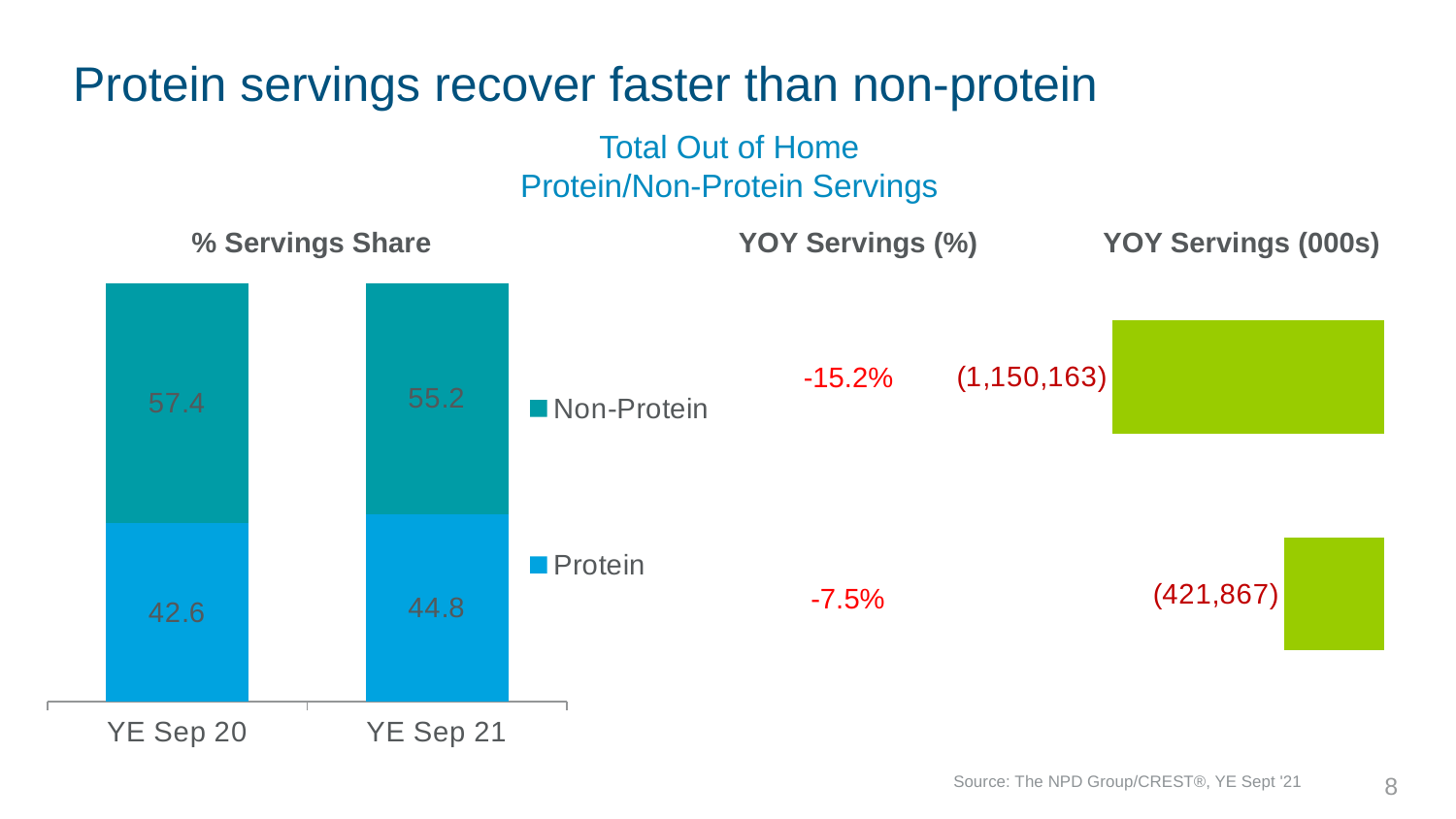
How many categories are shown on the x axis of the % Servings Share chart? 2 What kind of chart is the % Servings Share chart? Stacked bar chart In the % Servings Share chart, what is the total of the stacked bar for YE Sep 20? 100 In the % Servings Share chart, what is the Protein value for YE Sep 21? 44.8 In the YOY Servings (000s) chart, what is the value shown for Non-Protein? (1,150,163) In the % Servings Share chart, what is the Protein value for YE Sep 20? 42.6 In the % Servings Share chart, what is the Non-Protein value for YE Sep 21? 55.2 How many series does the legend of the % Servings Share chart list? 2 In the % Servings Share chart, which series has the larger share in YE Sep 21, Protein or Non-Protein? Non-Protein In the % Servings Share chart, by how much did the Protein share increase from YE Sep 20 to YE Sep 21? 2.2 In the YOY Servings (000s) chart, what is the value shown for Protein? (421,867) In the % Servings Share chart, what is the Non-Protein value for YE Sep 20? 57.4